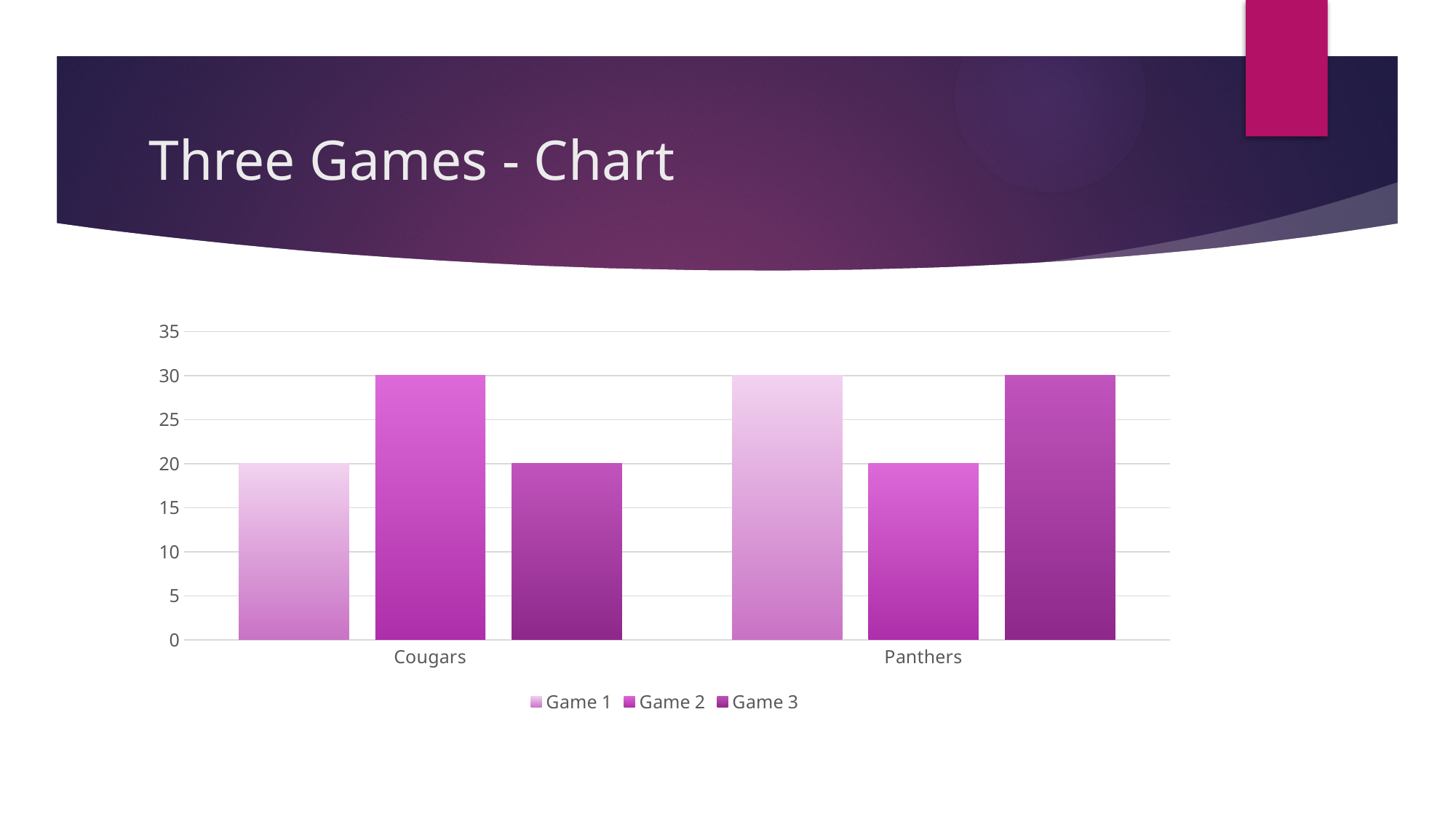
How many categories are shown on the x axis? 2 Which is larger, the Game 3 value for Cougars or the Game 3 value for Panthers? Panthers What is the Game 2 value for Panthers? 20 What is the difference between the Game 1 values for Panthers and Cougars? 10 What kind of chart is shown on the slide? bar chart What is the Game 1 value for Cougars? 20 What is the Game 2 value for Cougars? 30 What is the Game 3 value for Panthers? 30 Which game has the lowest value for Panthers? Game 2 How many series does the legend list? 3 What is the title of the slide containing the chart? Three Games - Chart Which game has the highest value for Cougars? Game 2